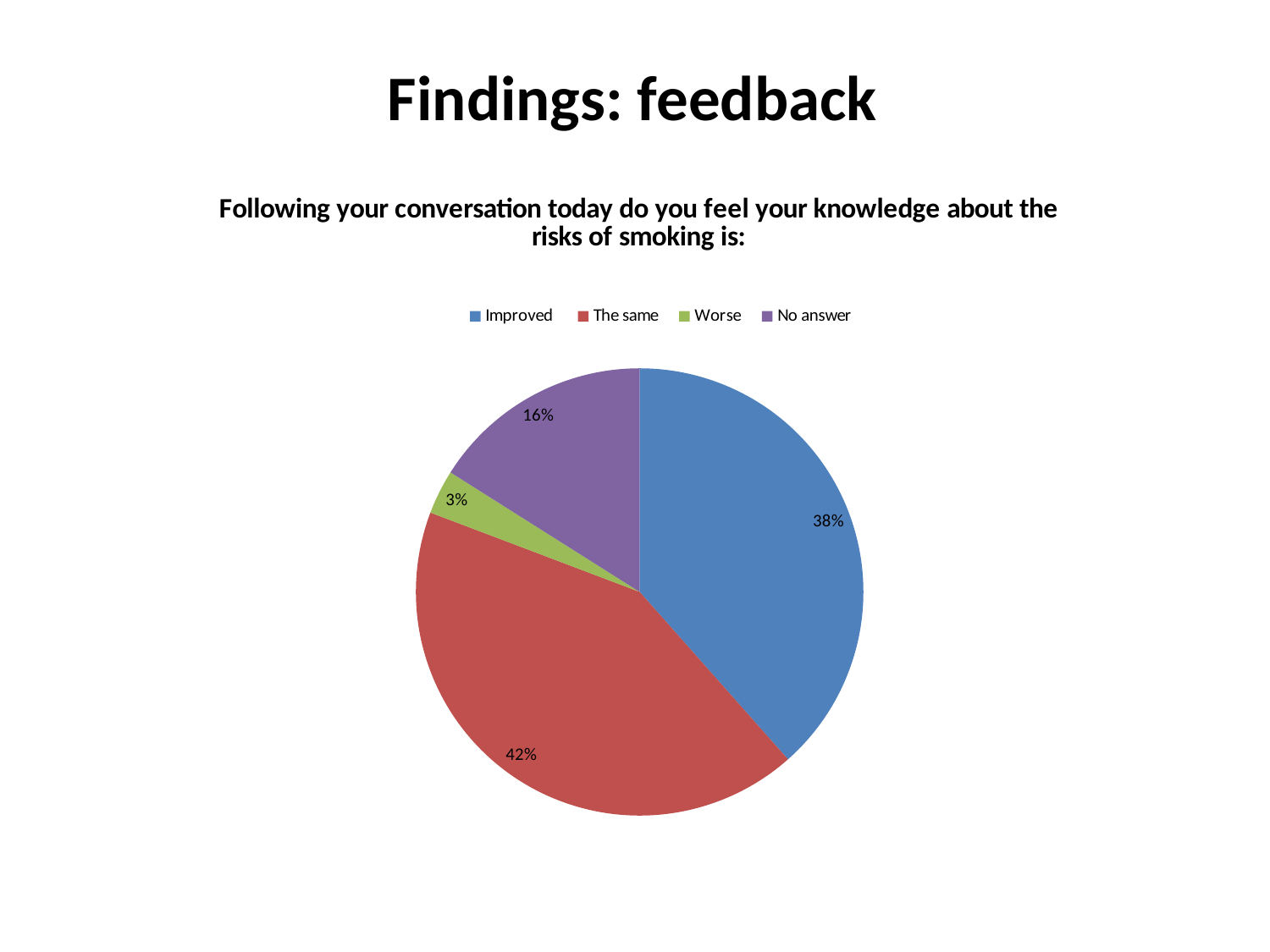
What share of the pie does the "Worse" slice represent? 3% What colour is the "Improved" slice in the pie chart? Blue How many categories does the pie chart show? 4 What share of the pie does the "No answer" slice represent? 16% What is the difference in percentage points between "The same" and "Improved"? 4% Which category has the largest slice of the pie? The same What share of the pie does the "Improved" slice represent? 38% What kind of chart is shown on the slide? Pie chart What is the difference in percentage points between "No answer" and "Worse"? 13% Which category has the smallest slice of the pie? Worse Which is larger, the "No answer" slice or the "Worse" slice? No answer